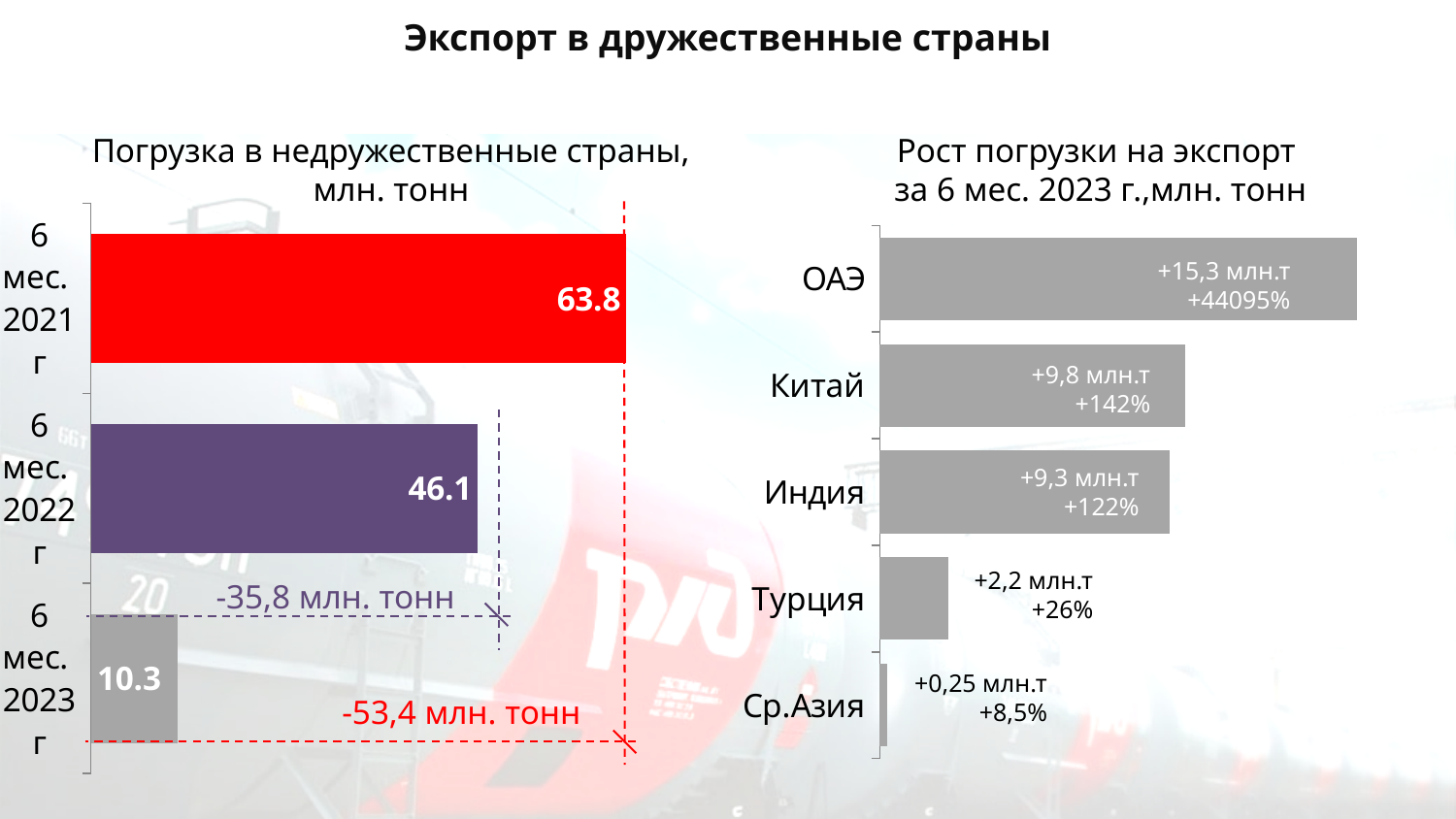
In the chart 'Погрузка в недружественные страны, млн. тонн', what is the value for 6 мес. 2021 г? 63.8 In the chart 'Погрузка в недружественные страны, млн. тонн', how many bars are plotted? 3 In the chart 'Рост погрузки на экспорт за 6 мес. 2023 г., млн. тонн', what is the growth in million tonnes for Китай? +9,8 млн.т In the chart 'Погрузка в недружественные страны, млн. тонн', which period has the lowest value? 6 мес. 2023 г In the chart 'Погрузка в недружественные страны, млн. тонн', do the values rise or fall from 6 мес. 2021 г to 6 мес. 2023 г? fall In the chart 'Рост погрузки на экспорт за 6 мес. 2023 г., млн. тонн', which is larger in million tonnes: Турция or Ср.Азия? Турция What kind of chart is 'Рост погрузки на экспорт за 6 мес. 2023 г., млн. тонн'? bar chart In the chart 'Рост погрузки на экспорт за 6 мес. 2023 г., млн. тонн', what percentage growth is shown for Индия? +122% In the chart 'Рост погрузки на экспорт за 6 мес. 2023 г., млн. тонн', how many countries are listed? 5 In the chart 'Погрузка в недружественные страны, млн. тонн', what is the value for 6 мес. 2023 г? 10.3 In the chart 'Рост погрузки на экспорт за 6 мес. 2023 г., млн. тонн', which country has the highest growth in million tonnes? ОАЭ In the chart 'Погрузка в недружественные страны, млн. тонн', what is the difference between the values for 6 мес. 2021 г and 6 мес. 2022 г? 17.7